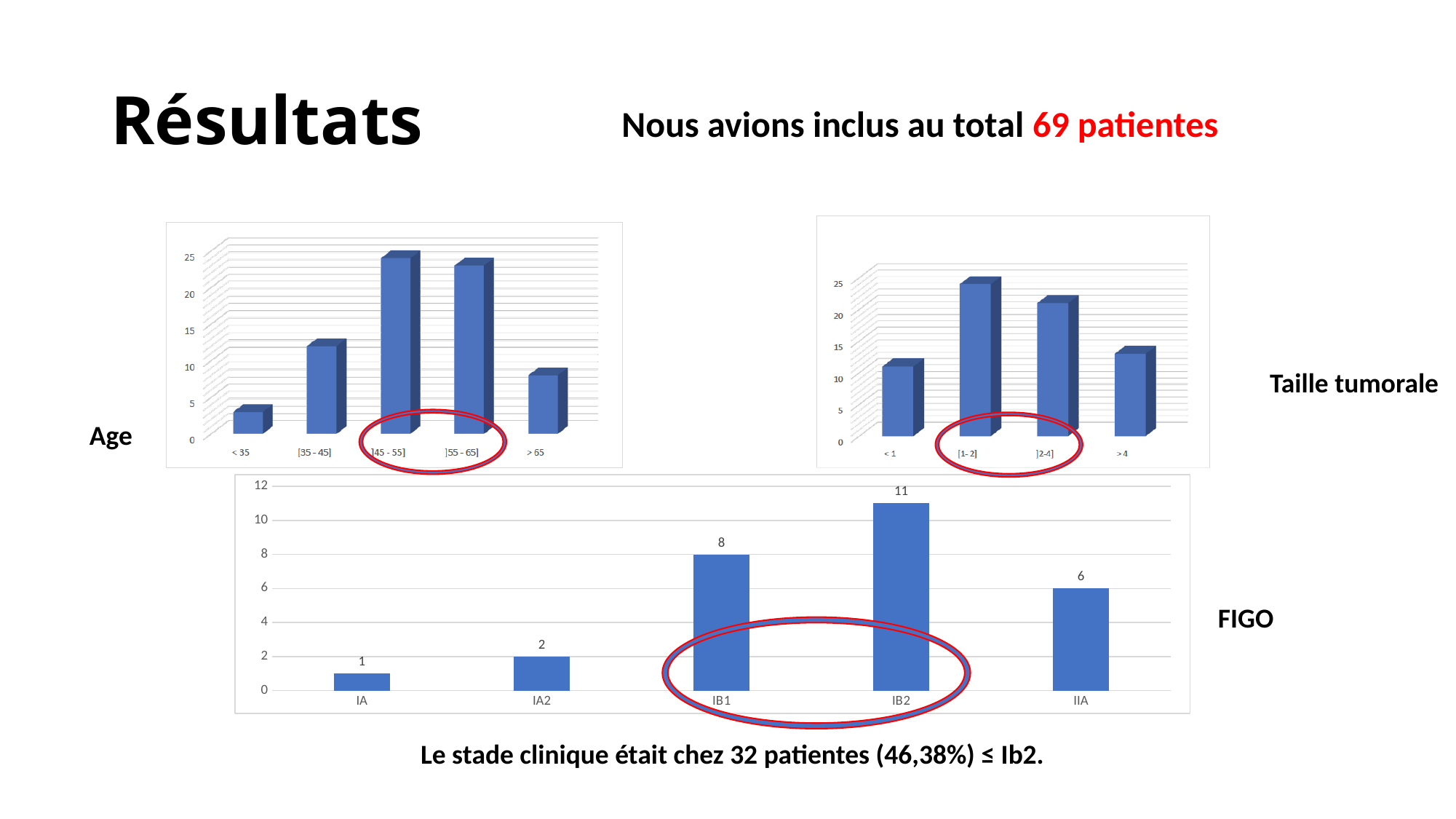
In the FIGO chart, what is the value for IB2? 11 In the Taille tumorale chart, which category has the highest value? [1- 2] In the Taille tumorale chart, is the value for ]2-4] greater or less than 20? greater In the FIGO chart, what is the value for IB1? 8 In the Age chart, which category has the lowest value? < 35 In the FIGO chart, which category has the lowest value? IA In the FIGO chart, what is the value for IIA? 6 In the FIGO chart, what is the difference between the values for IB2 and IB1? 3 In the FIGO chart, how many categories are shown on the x axis? 5 In the Age chart, is the value for [35 - 45] greater or less than 10? greater What kind of chart is the FIGO chart? bar chart In the FIGO chart, which category has the highest value? IB2